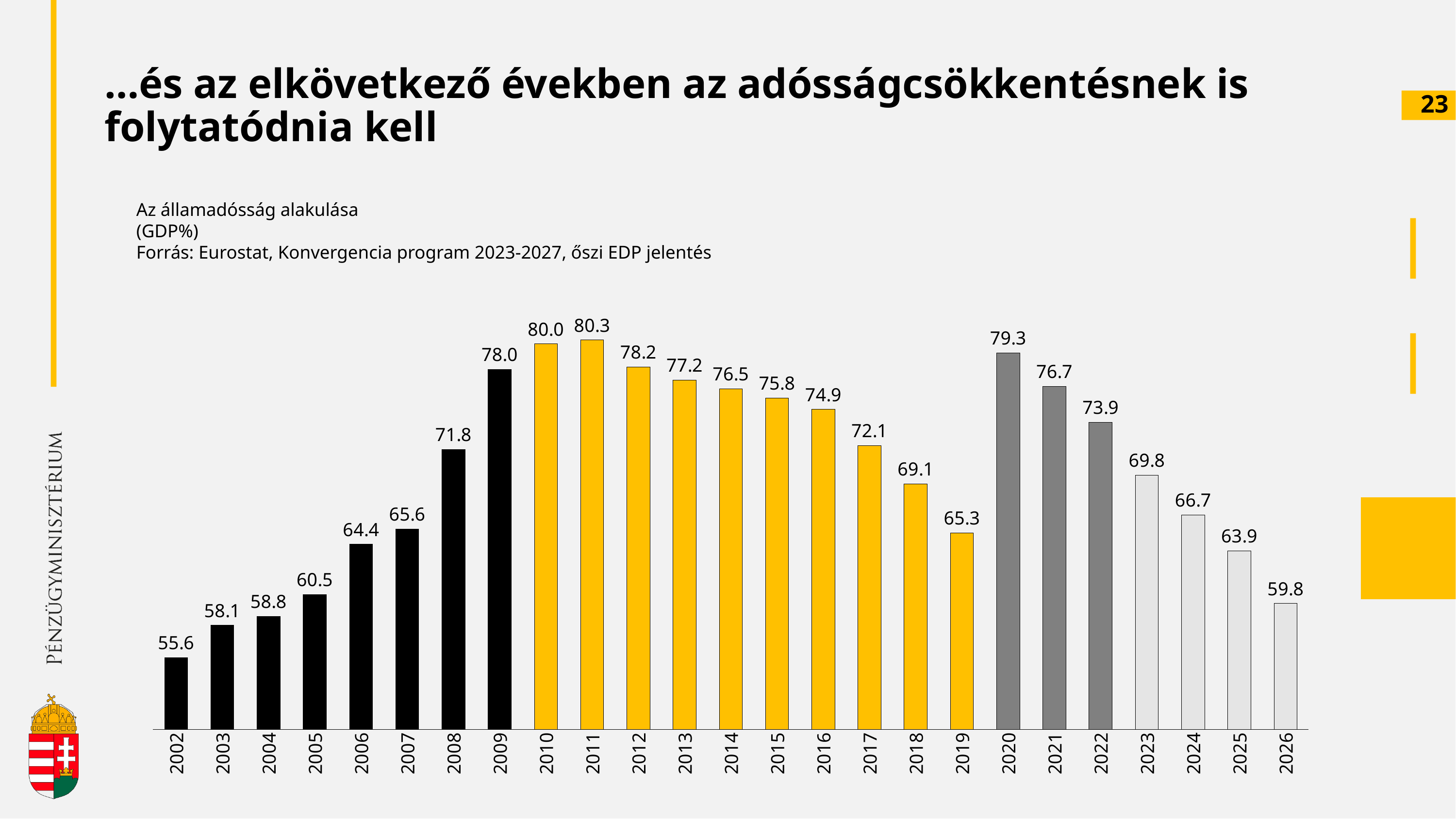
Which is larger, the value for 2009 or the value for 2019? 2009 Which year has the lowest value? 2002 What is the value for 2011? 80.3 What kind of chart is shown? bar chart Do the values rise or fall from 2020 to 2026? fall What is the value for 2026? 59.8 Which year has the highest value? 2011 What is the difference between the values for 2020 and 2026? 19.5 How many years are shown on the x axis? 25 What is the title of the chart? Az államadósság alakulása (GDP%) What is the difference between the values for 2002 and 2011? 24.7 What is the value for 2020? 79.3